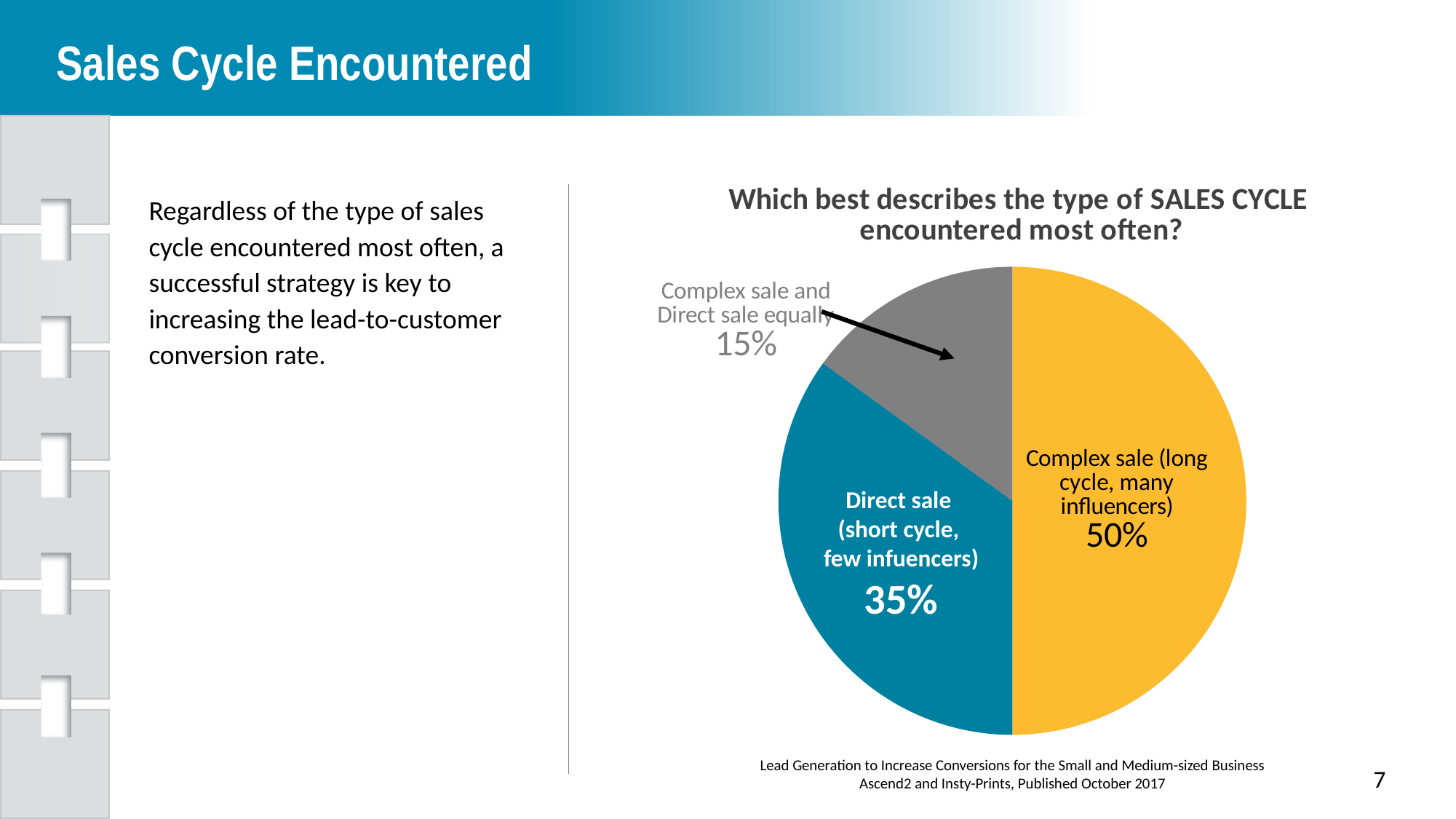
What colour is the slice for direct sale (short cycle, few influencers)? Blue Which sales cycle type has the largest share of the pie? Complex sale (long cycle, many influencers) Which sales cycle type has the smallest share of the pie? Complex sale and Direct sale equally What is the title of the pie chart? Which best describes the type of SALES CYCLE encountered most often? What is the difference in percentage points between the direct sale share and the 'equally' share? 20 What percentage of respondents said they encounter complex sale and direct sale equally? 15% What type of chart is shown on the slide? Pie chart What percentage of respondents said they most often encounter a direct sale (short cycle, few influencers)? 35% How many slices does the pie chart have? 3 What is the difference in percentage points between the complex sale share and the direct sale share? 15 What percentage of respondents said they most often encounter a complex sale (long cycle, many influencers)? 50% Which is larger: the share for direct sale or the share for complex sale and direct sale equally? Direct sale